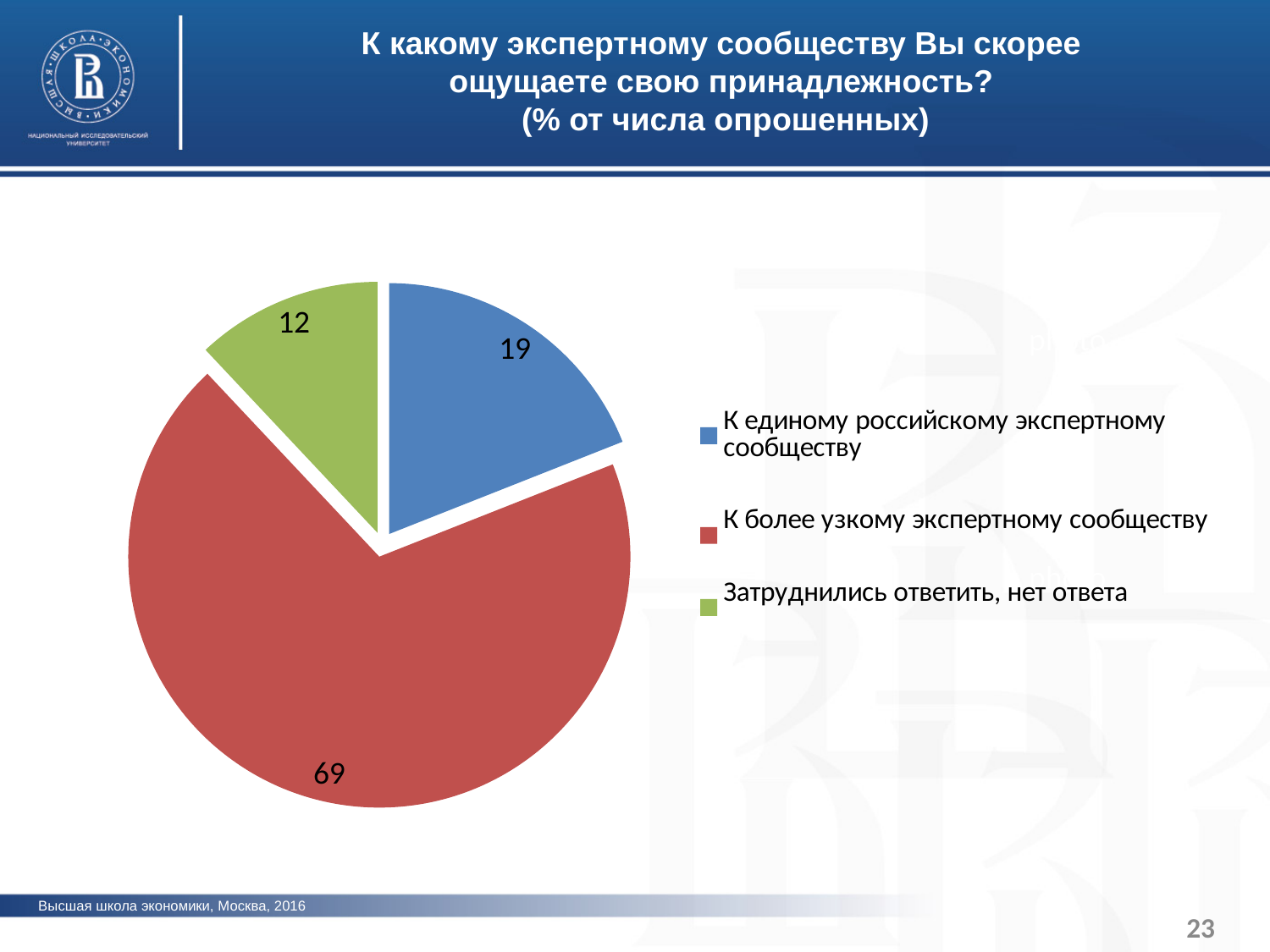
What colour is the slice for "К более узкому экспертному сообществу"? red Which is larger: the value for "К единому российскому экспертному сообществу" or for "Затруднились ответить, нет ответа"? К единому российскому экспертному сообществу What is the value for "Затруднились ответить, нет ответа"? 12 What is the value for "К более узкому экспертному сообществу"? 69 What is the title of the chart on the slide? К какому экспертному сообществу Вы скорее ощущаете свою принадлежность? (% от числа опрошенных) How many entries does the legend list? 3 What is the difference between the values for "К более узкому экспертному сообществу" and "К единому российскому экспертному сообществу"? 50 Which category has the largest slice of the pie? К более узкому экспертному сообществу Which category has the smallest slice of the pie? Затруднились ответить, нет ответа How many slices does the pie chart have? 3 What kind of chart is shown on the slide? pie chart What is the value for "К единому российскому экспертному сообществу"? 19